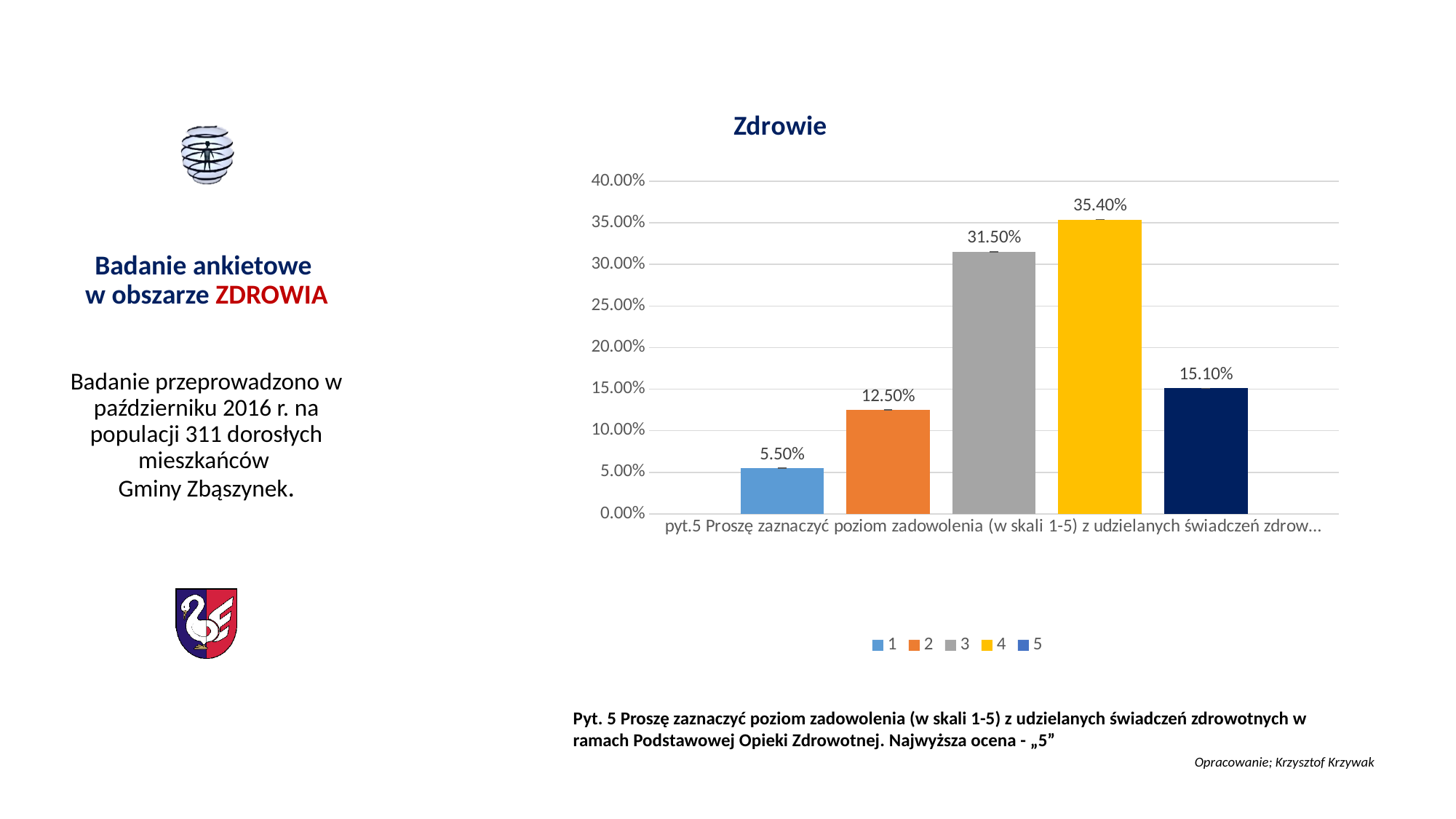
Which is larger in the Zdrowie chart, the value for rating 2 or the value for rating 5? 5 What is the difference between the values for rating 5 and rating 2 in the Zdrowie chart? 2.60% Which rating has the lowest value in the Zdrowie chart? 1 How many series does the legend of the Zdrowie chart list? 5 What kind of chart is the Zdrowie chart? bar chart What is the difference between the values for rating 4 and rating 3 in the Zdrowie chart? 3.90% What is the value for rating 4 in the Zdrowie chart? 35.40% What is the value for rating 5 in the Zdrowie chart? 15.10% Is the value for rating 3 in the Zdrowie chart greater or less than 30.00%? greater Which rating has the highest value in the Zdrowie chart? 4 What is the title of the chart on the slide? Zdrowie What is the value for rating 1 in the Zdrowie chart? 5.50%